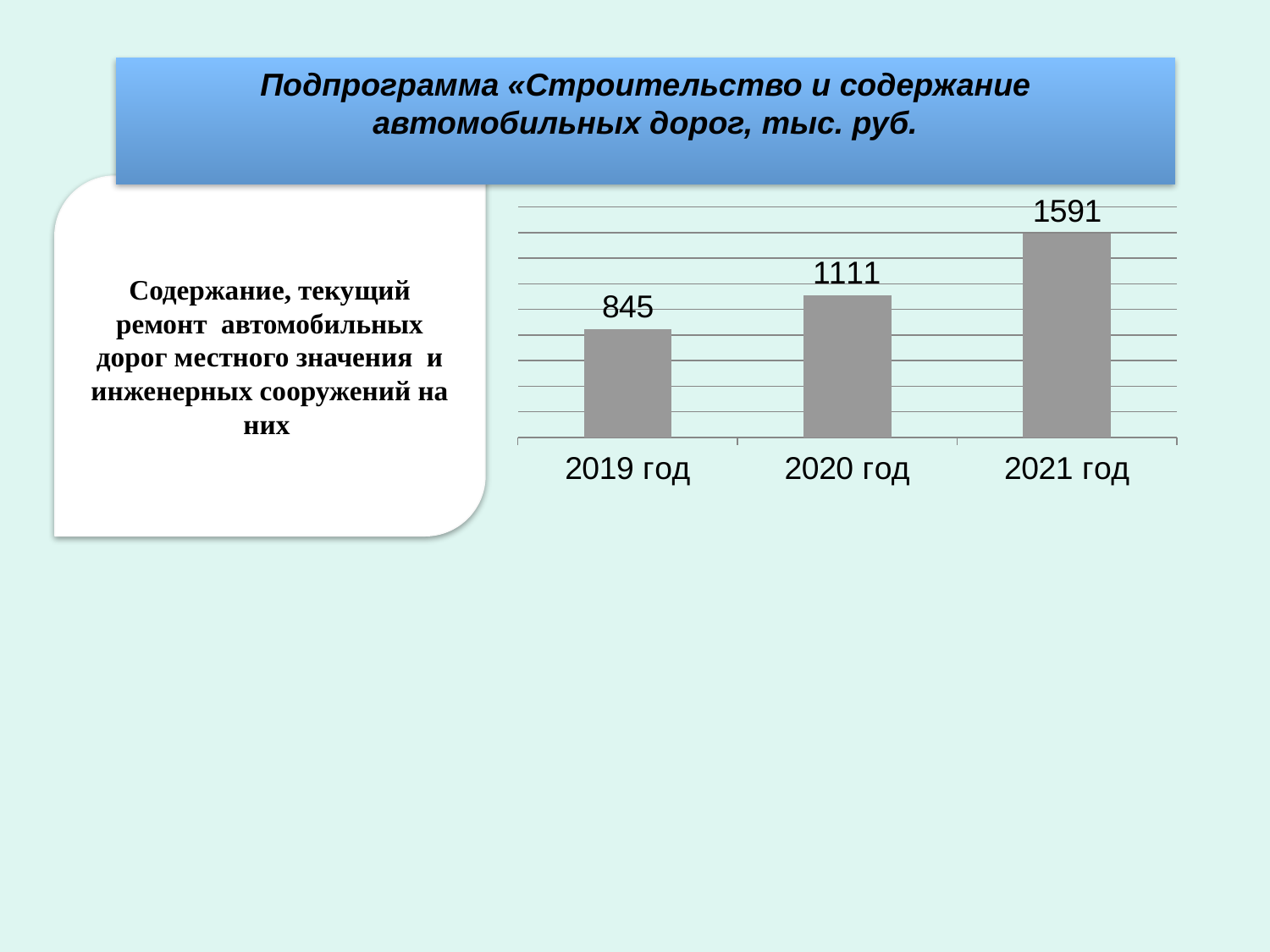
What is the difference between the values for 2021 год and 2019 год? 746 Which is larger, the value for 2020 год or the value for 2021 год? 2021 год What is the difference between the values for 2020 год and 2019 год? 266 Which year has the lowest value? 2019 год How many years are shown on the chart? 3 What unit is stated in the slide title for the chart values? тыс. руб. What is the value for 2019 год? 845 What is the value for 2021 год? 1591 What is the value for 2020 год? 1111 Which year has the highest value? 2021 год What kind of chart is shown on the slide? bar chart Do the values rise or fall from 2019 год to 2021 год? rise